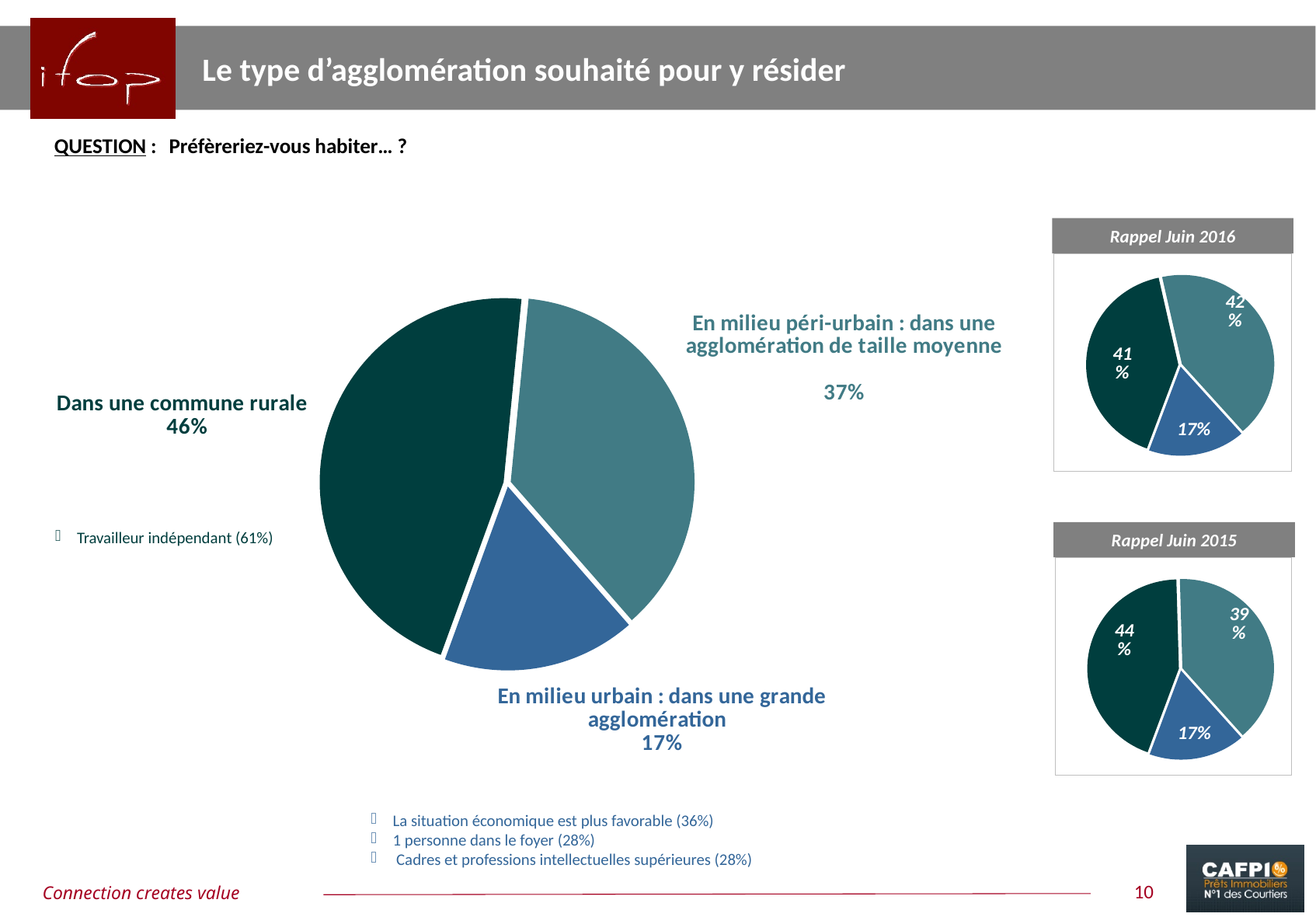
How many pie charts are shown on the slide in total? 3 In the main pie chart, which is larger: the share for the rural commune or the share for the peri-urban setting? Dans une commune rurale In the main pie chart, what share of respondents prefer to live in a rural commune (Dans une commune rurale)? 46% In the 'Rappel Juin 2015' pie chart, what is the smallest value shown? 17% How many slices does the main pie chart have? 3 In the 'Rappel Juin 2016' pie chart, what is the largest value shown? 42% In the main pie chart, which category has the largest share? Dans une commune rurale In the main pie chart, what share of respondents prefer an urban setting in a large agglomeration (En milieu urbain)? 17% In the main pie chart, which category has the smallest share? En milieu urbain : dans une grande agglomération What type of chart is used to show the preferred type of agglomeration on this slide? Pie chart In the main pie chart, what share of respondents prefer a peri-urban setting (En milieu péri-urbain)? 37% In the main pie chart, what is the difference in percentage points between the rural commune share and the peri-urban share? 9